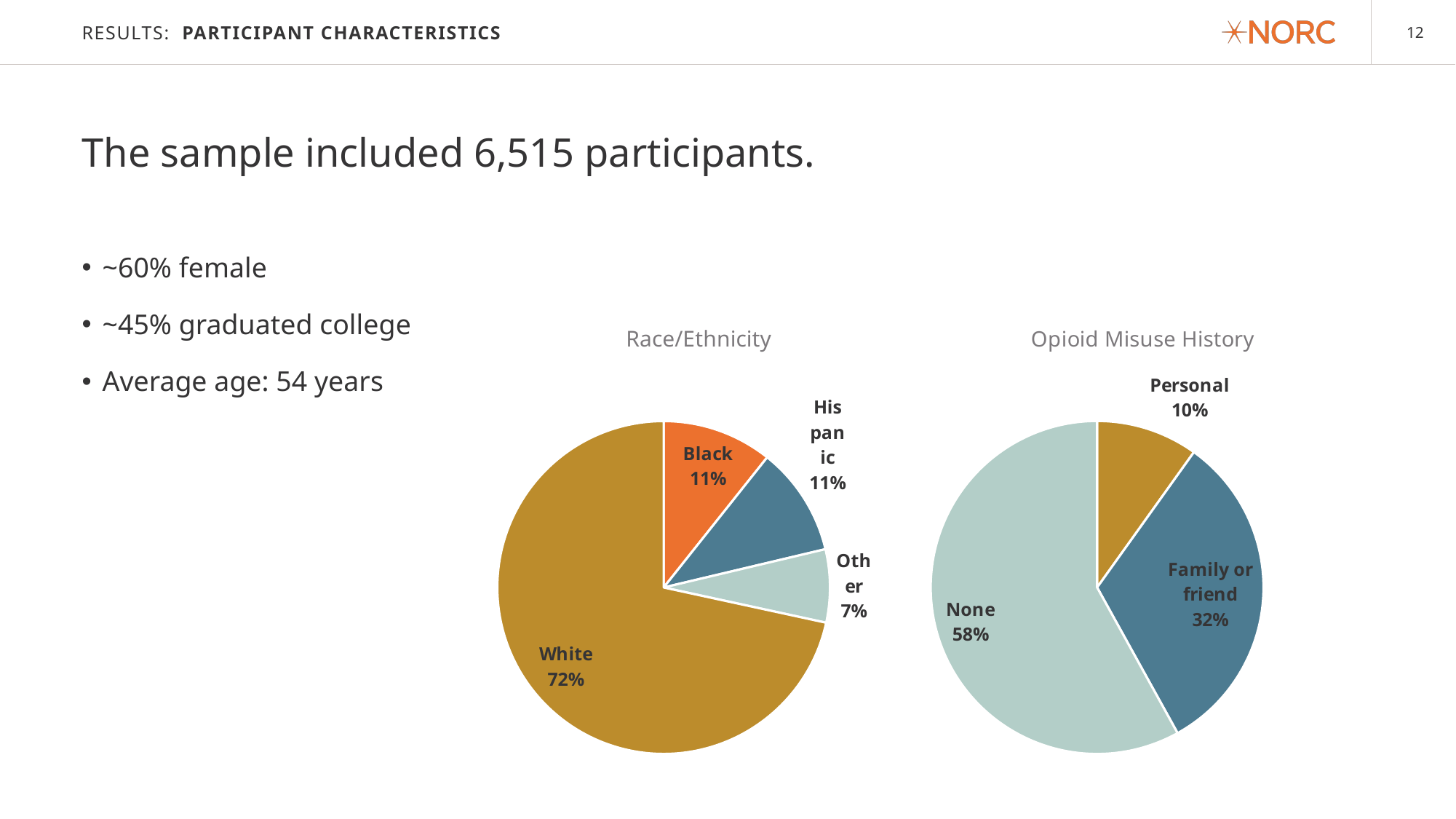
In the Opioid Misuse History chart, what share of participants reported a Family or friend history? 32% In the Opioid Misuse History chart, which category has the largest slice? None In the Race/Ethnicity chart, what is the difference between the White share and the Black share? 61% In the Race/Ethnicity chart, what share of participants are Black? 11% In the Race/Ethnicity chart, what share of participants are in the Other category? 7% In the Opioid Misuse History chart, what share of participants reported a Personal history? 10% In the Race/Ethnicity chart, which category has the largest slice? White In the Opioid Misuse History chart, is the share for None or for Family or friend larger? None In the Race/Ethnicity chart, which category has the smallest slice? Other In the Race/Ethnicity chart, how many categories are shown? 4 In the Race/Ethnicity chart, what share of participants are White? 72% What type of chart is the Opioid Misuse History chart? Pie chart